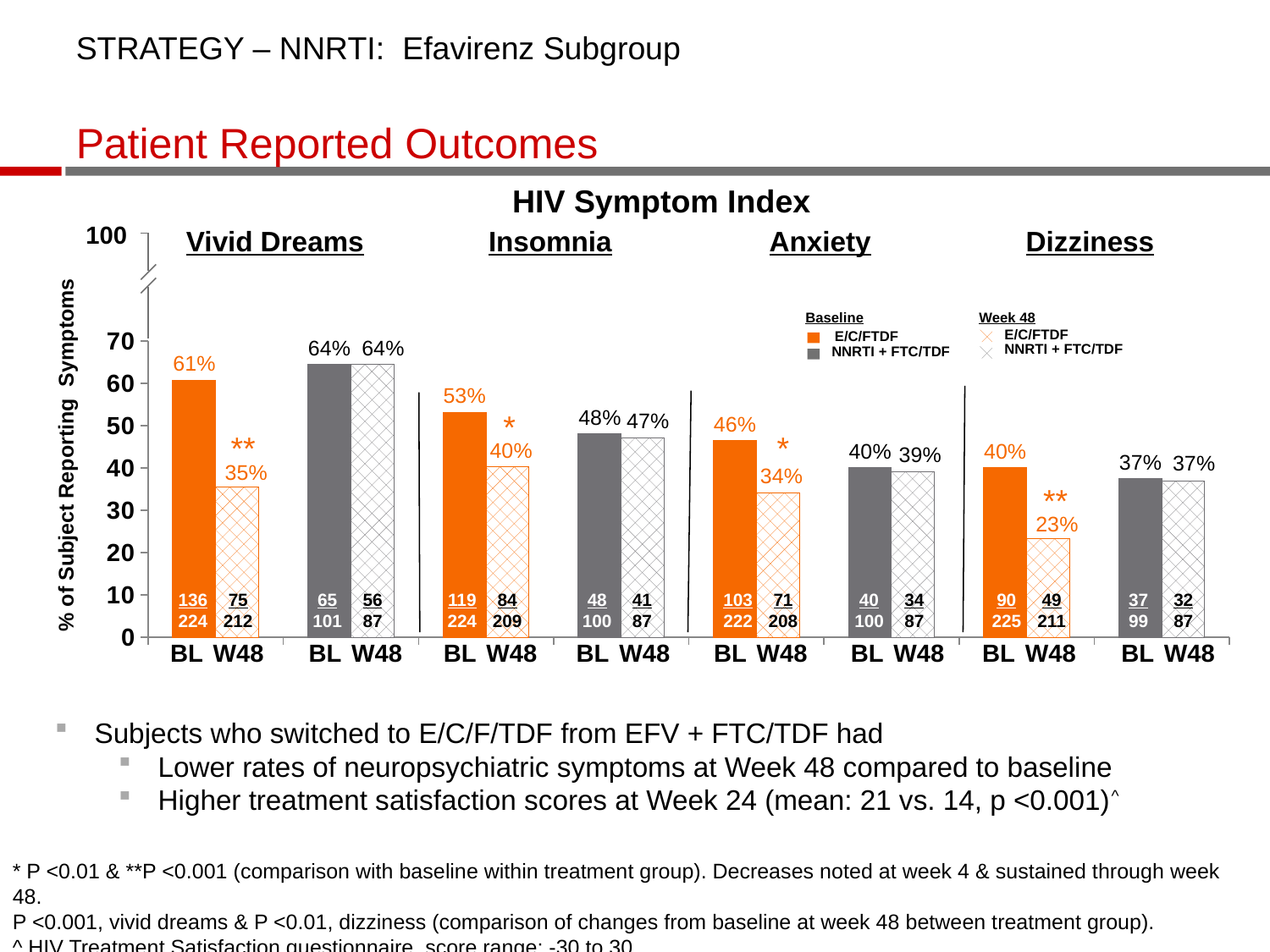
In the HIV Symptom Index chart, what percentage of NNRTI + FTC/TDF subjects reported insomnia at baseline? 48% How many symptom categories are shown in the HIV Symptom Index chart? 4 In the HIV Symptom Index chart, which bar shows the lowest percentage across all symptoms and groups? E/C/FTDF Week 48 for Dizziness (23%) How many entries does the legend of the HIV Symptom Index chart list? 4 In the HIV Symptom Index chart, which symptom has the highest baseline percentage for the NNRTI + FTC/TDF group? Vivid Dreams What type of chart is the HIV Symptom Index chart? Bar chart In the HIV Symptom Index chart, what percentage of E/C/FTDF subjects reported dizziness at Week 48? 23% In the HIV Symptom Index chart, what percentage of E/C/FTDF subjects reported vivid dreams at baseline? 61% In the HIV Symptom Index chart, what percentage of E/C/FTDF subjects reported vivid dreams at Week 48? 35% In the HIV Symptom Index chart, what is the difference between the E/C/FTDF baseline and Week 48 percentages for anxiety? 12% In the HIV Symptom Index chart, which is larger for insomnia at Week 48: the E/C/FTDF percentage or the NNRTI + FTC/TDF percentage? NNRTI + FTC/TDF (47%) In the HIV Symptom Index chart, what is the difference between the E/C/FTDF baseline and Week 48 percentages for vivid dreams? 26%